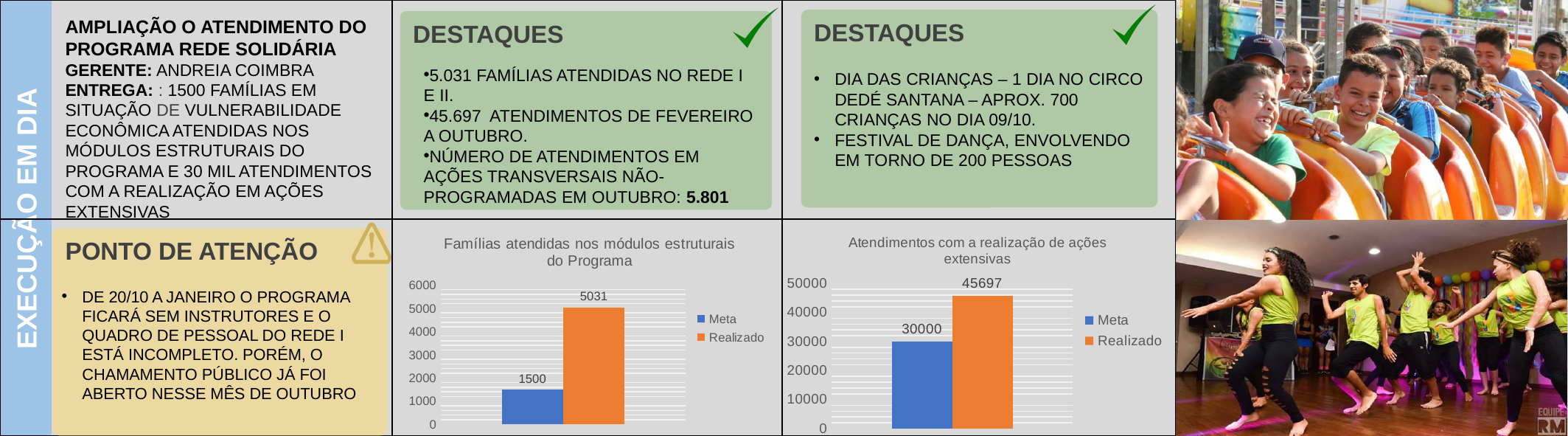
How many series does the legend list in the chart titled 'Famílias atendidas nos módulos estruturais do Programa'? 2 In the chart titled 'Atendimentos com a realização de ações extensivas', what is the value for Meta? 30000 In the chart titled 'Famílias atendidas nos módulos estruturais do Programa', what colour is the Realizado bar? orange In the chart titled 'Atendimentos com a realização de ações extensivas', which series has the lower value? Meta In the chart titled 'Famílias atendidas nos módulos estruturais do Programa', what is the value for Meta? 1500 In the chart titled 'Famílias atendidas nos módulos estruturais do Programa', what is the difference between Realizado and Meta? 3531 In the chart titled 'Famílias atendidas nos módulos estruturais do Programa', which series has the higher value, Meta or Realizado? Realizado In the chart titled 'Famílias atendidas nos módulos estruturais do Programa', what is the value for Realizado? 5031 What kind of chart is the chart titled 'Atendimentos com a realização de ações extensivas'? bar chart In the chart titled 'Atendimentos com a realização de ações extensivas', is the value for Realizado greater or less than 40000? greater In the chart titled 'Atendimentos com a realização de ações extensivas', what is the value for Realizado? 45697 In the chart titled 'Atendimentos com a realização de ações extensivas', what is the difference between Realizado and Meta? 15697